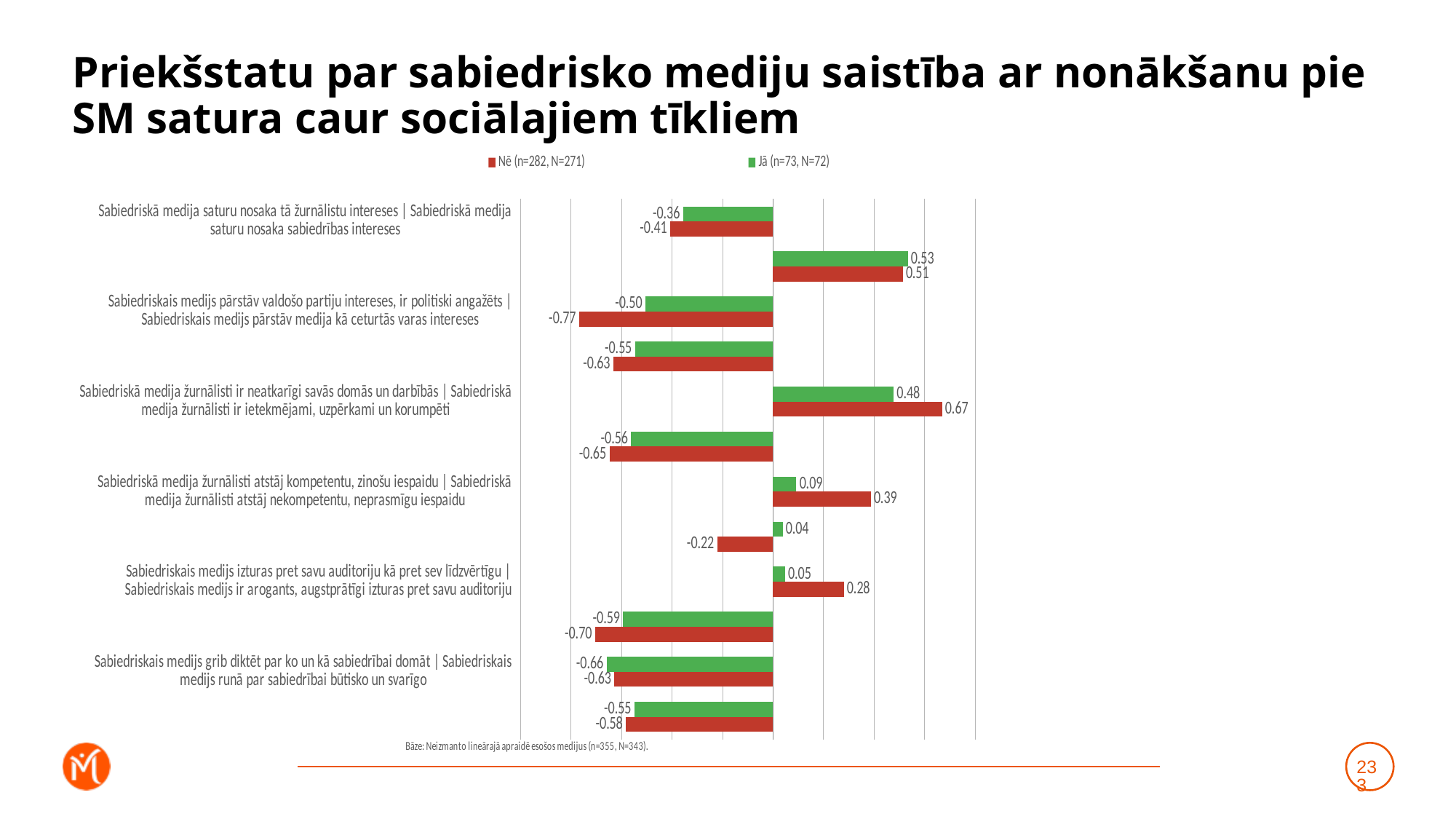
For the category 'Sabiedriskais medijs izturas pret savu auditoriju kā pret sev līdzvērtīgu | Sabiedriskais medijs ir arogants, augstprātīgi izturas pret savu auditoriju', which series has the larger value? Nē (n=282, N=271) What is the value for the Jā (n=73, N=72) series for the category 'Sabiedriskā medija saturu nosaka tā žurnālistu intereses | Sabiedriskā medija saturu nosaka sabiedrības intereses'? -0.36 For the category 'Sabiedriskā medija žurnālisti atstāj kompetentu, zinošu iespaidu | Sabiedriskā medija žurnālisti atstāj nekompetentu, neprasmīgu iespaidu', what is the difference between the Nē (n=282, N=271) value and the Jā (n=73, N=72) value? 0.30 What is the highest value shown on the chart? 0.67 What kind of chart is shown on the slide? bar chart What colour represents the Jā (n=73, N=72) series in the legend? green What is the value for the Jā (n=73, N=72) series for the category 'Sabiedriskā medija žurnālisti ir neatkarīgi savās domās un darbībās | Sabiedriskā medija žurnālisti ir ietekmējami, uzpērkami un korumpēti'? 0.48 What is the value for the Nē (n=282, N=271) series for the category 'Sabiedriskais medijs pārstāv valdošo partiju intereses, ir politiski angažēts | Sabiedriskais medijs pārstāv medija kā ceturtās varas intereses'? -0.77 What is the lowest value shown on the chart? -0.77 What is the value for the Jā (n=73, N=72) series for the category 'Sabiedriskais medijs grib diktēt par ko un kā sabiedrībai domāt | Sabiedriskais medijs runā par sabiedrībai būtisko un svarīgo'? -0.66 What is the value for the Nē (n=282, N=271) series for the category 'Sabiedriskā medija žurnālisti ir neatkarīgi savās domās un darbībās | Sabiedriskā medija žurnālisti ir ietekmējami, uzpērkami un korumpēti'? 0.67 How many series does the legend list? 2